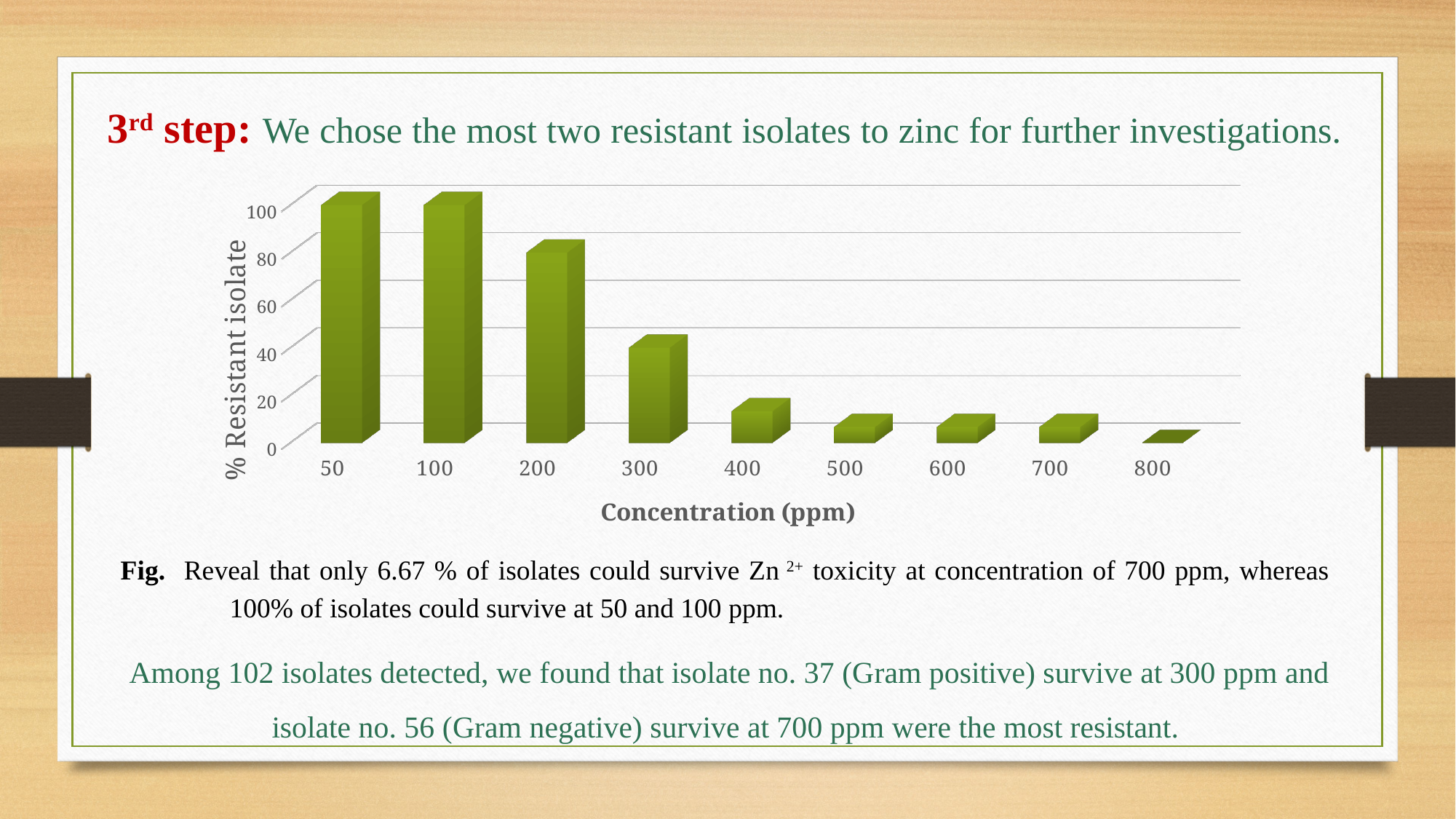
How many concentration categories are plotted on the x axis? 9 Which concentration has the lowest % resistant isolate? 800 Is the value for 400 ppm greater or less than 20? less What is the % resistant isolate value at 50 ppm? 100 What is the % resistant isolate value at 800 ppm? 0 Is the value for 200 ppm greater or less than 60? greater Which has a higher % resistant isolate, 200 ppm or 300 ppm? 200 ppm What is the title of the x axis? Concentration (ppm) Is the value for 300 ppm greater or less than 60? less What kind of chart is shown on the slide? bar chart What is the title of the y axis? % Resistant isolate Do the values rise or fall as concentration increases along the x axis? fall